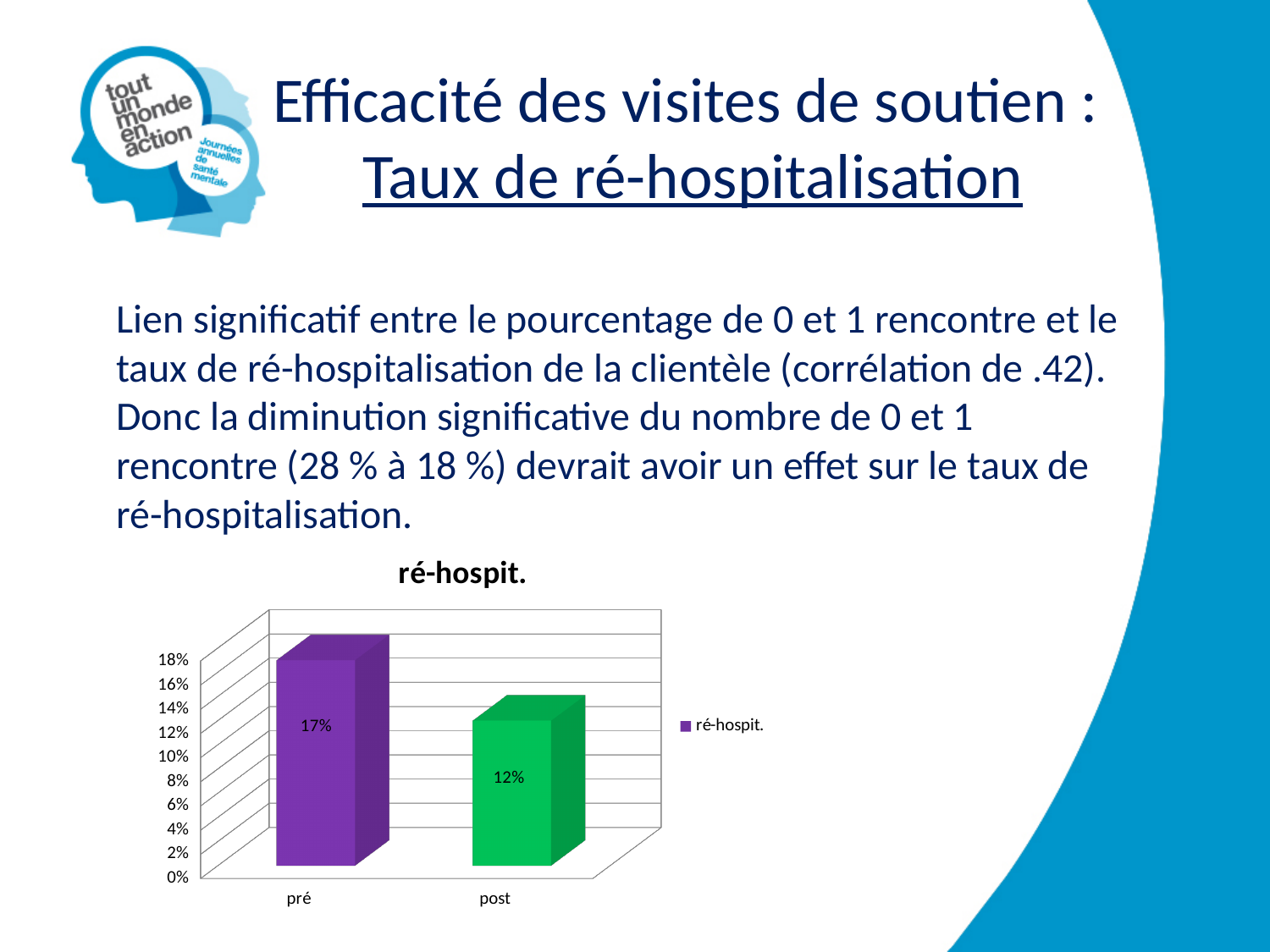
What is the value for post in the ré-hospit. chart? 12% What kind of chart is shown on the slide? bar chart Is the value for pré greater or less than 16%? greater Do the values rise or fall from pré to post in the ré-hospit. chart? fall Is the value for post greater or less than 14%? less Which category has the highest value in the ré-hospit. chart? pré What is the difference between the pré and post values in the ré-hospit. chart? 5% Which category has the lowest value in the ré-hospit. chart? post What is the value for pré in the ré-hospit. chart? 17% Which is larger in the ré-hospit. chart, pré or post? pré How many categories are shown on the x axis of the ré-hospit. chart? 2 How many series does the legend of the ré-hospit. chart list? 1